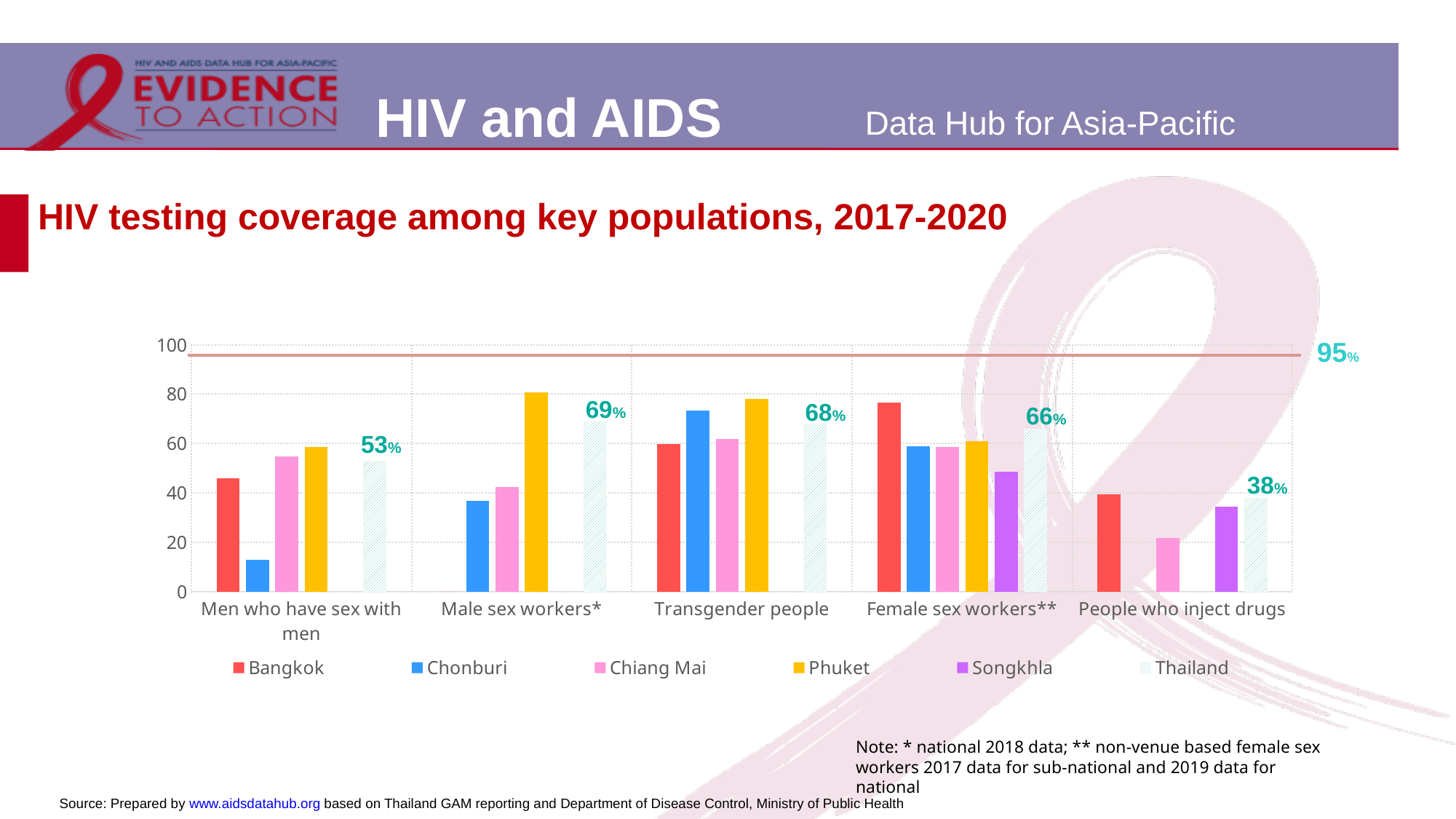
What value is marked by the horizontal target line across the chart? 95% Among the Thailand values, which key population has the highest HIV testing coverage? Male sex workers For Men who have sex with men, which is larger: the Bangkok value or the Chonburi value? Bangkok What is the Thailand value for People who inject drugs? 38% Is the Chonburi value for Men who have sex with men greater or less than 20? less What is the Thailand value for Male sex workers? 69% What is the difference between the Thailand values for Male sex workers and People who inject drugs? 31 percentage points What kind of chart is shown on the slide? Bar chart What is the Thailand value for Men who have sex with men? 53% Among the Thailand values, which key population has the lowest HIV testing coverage? People who inject drugs How many key population categories are shown on the x axis? 5 How many series does the legend list? 6